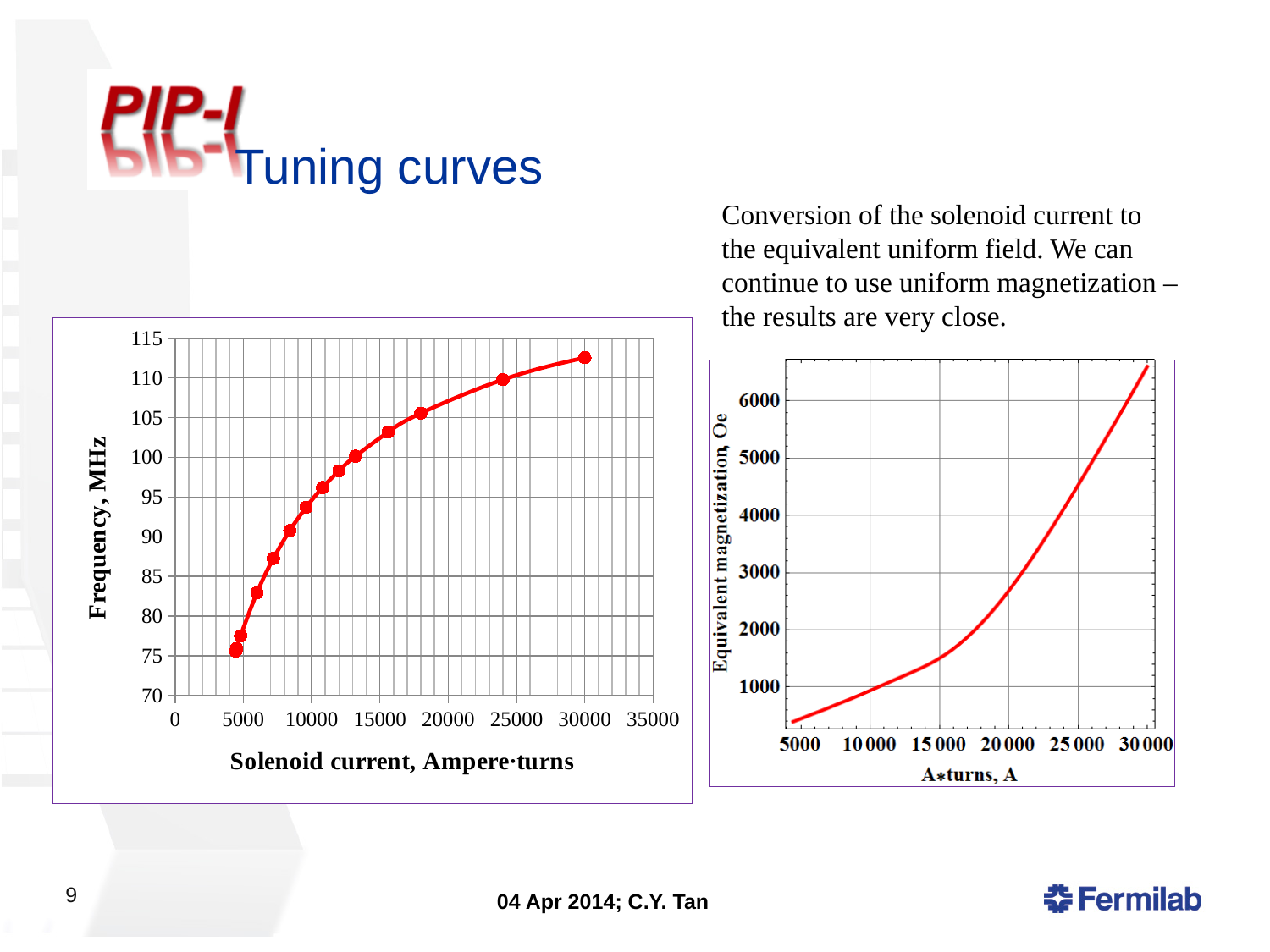
In the right chart, is the equivalent magnetization at 25000 A*turns greater or less than 3000 Oe? greater In the right chart, is the equivalent magnetization at 30000 A*turns greater or less than 6000 Oe? greater In the right chart, does the equivalent magnetization rise or fall as A*turns increases? rises In the right chart, is the equivalent magnetization at 15000 A*turns greater or less than 2000 Oe? less What is the x-axis label of the right chart? A*turns, A What kind of chart is the left chart, Frequency vs Solenoid current? line chart In the left chart, which is larger: the frequency at 10000 Ampere·turns or at 20000 Ampere·turns? 20000 Ampere·turns What is the y-axis label of the left chart? Frequency, MHz In the left chart, does the frequency rise or fall as the solenoid current increases? rises